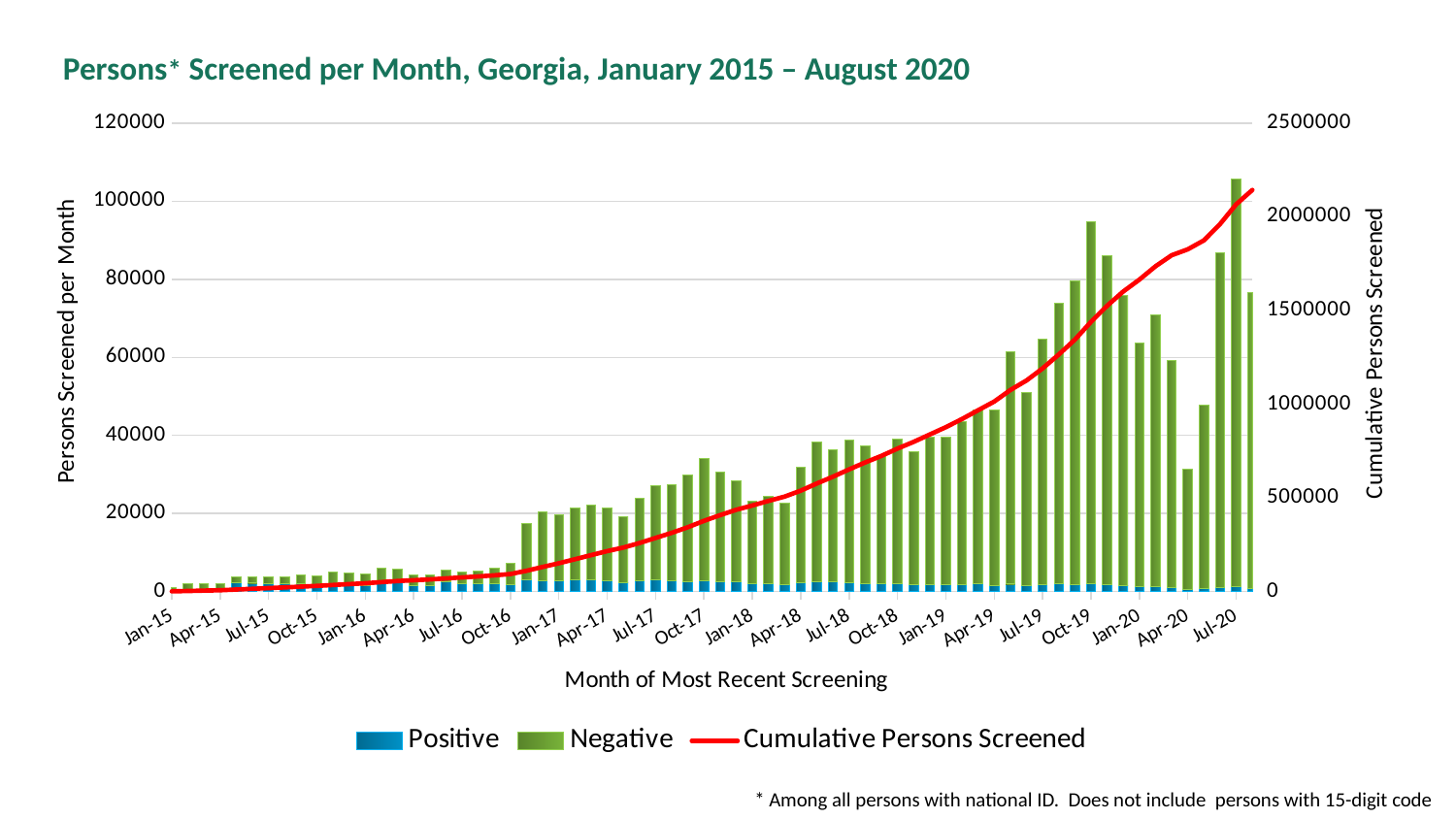
Is the total bar for Apr-20 greater or less than 40000 persons screened per month? less Is the total bar for Jan-15 greater or less than 20000 persons screened per month? less Does the Cumulative Persons Screened line rise or fall from Jan-15 to Aug-20? rise Which is larger, the total bar for Oct-19 or the total bar for Apr-20? Oct-19 Which month has the tallest bar for persons screened per month? Jul-20 Is the total bar for Oct-19 greater or less than 80000 persons screened per month? greater How many series does the legend list? 3 What kind of chart is shown on the slide? A stacked bar chart combined with a line chart What is the title of the right-hand vertical axis? Cumulative Persons Screened